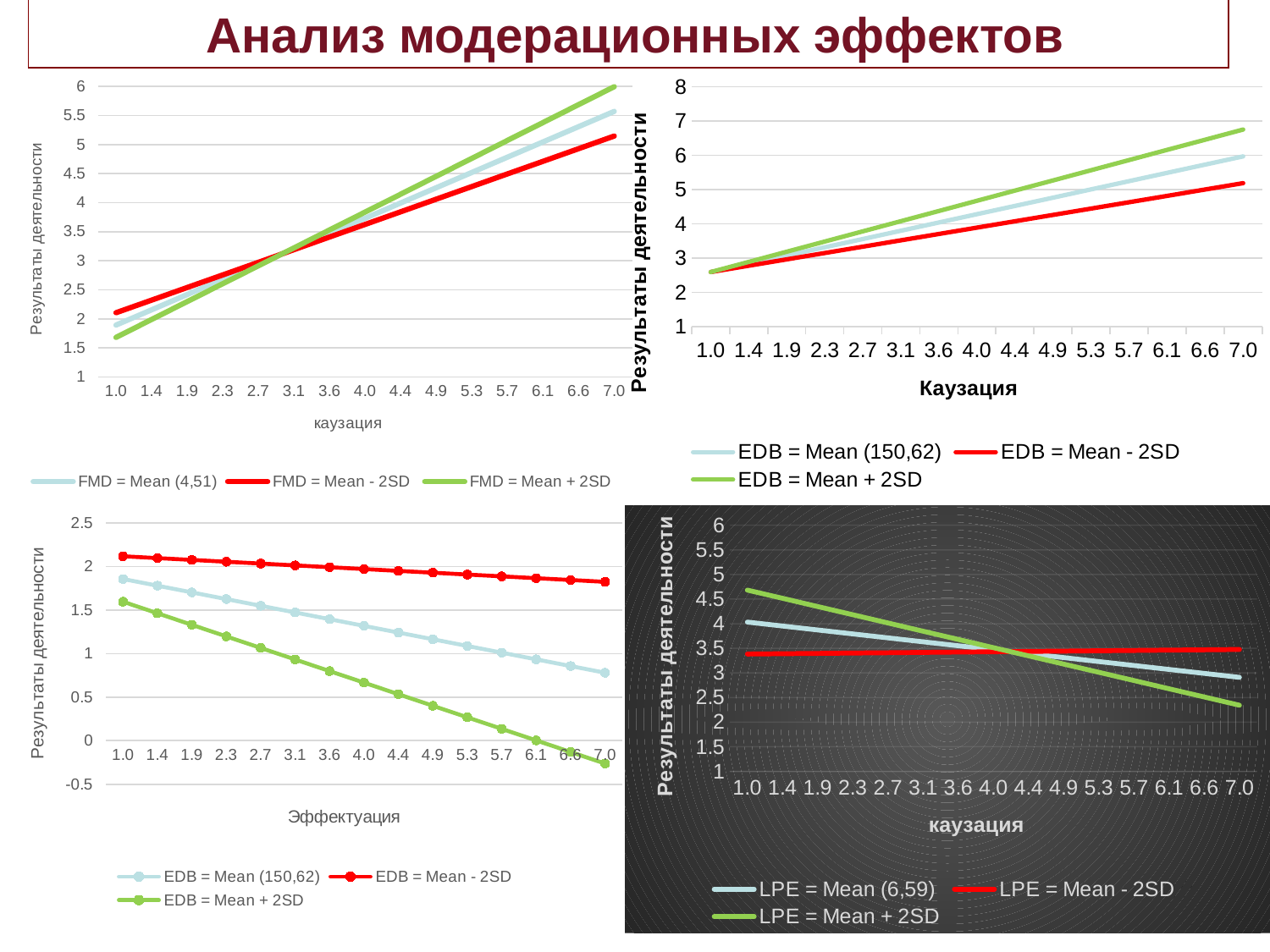
In the top-left chart (FMD), do the values rise or fall as каузация increases from 1.0 to 7.0? Rise How many x-axis points are plotted in the bottom-right chart (LPE)? 15 In the bottom-left chart (x axis Эффектуация), do the values rise or fall as Эффектуация increases from 1.0 to 7.0? Fall In the bottom-left chart (x axis Эффектуация), is the value of EDB = Mean + 2SD at 7.0 greater or less than 0? less In the top-left chart (FMD), how many series does the legend list? 3 How many charts are shown on the slide? 4 In the bottom-left chart (x axis Эффектуация), which series has the highest value at 7.0? EDB = Mean - 2SD In the bottom-right chart (LPE), which series has the highest value at 1.0? LPE = Mean + 2SD In the top-right chart (EDB, x axis Каузация), is the value of EDB = Mean + 2SD at 7.0 greater or less than 6? greater What kind of chart is the top-left chart with the FMD legend? Line chart In the top-left chart (FMD), is the value of FMD = Mean + 2SD at 7.0 greater or less than 5? greater In the top-right chart (EDB, x axis Каузация), which series has the lowest value at 7.0? EDB = Mean - 2SD